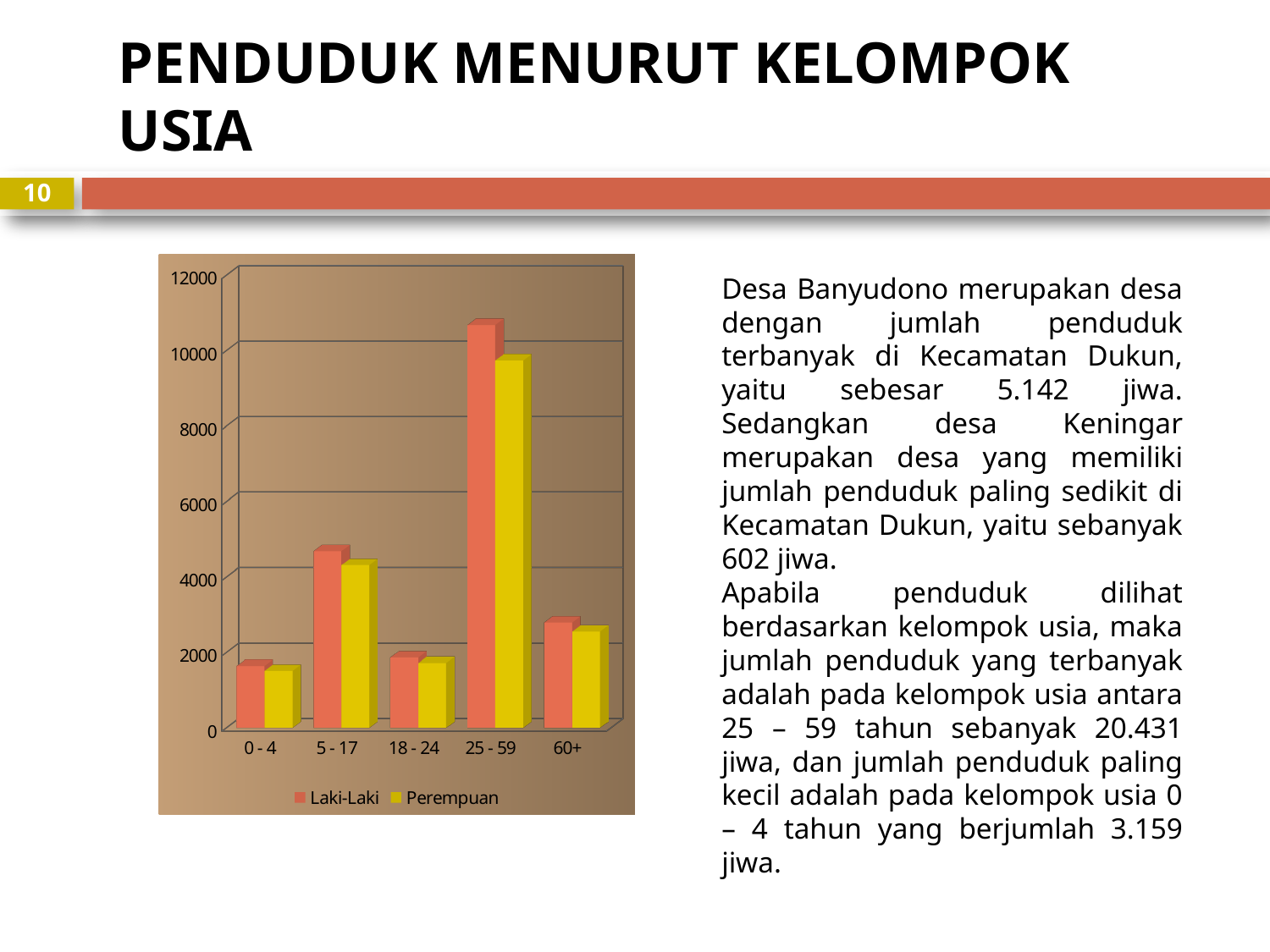
What kind of chart is shown on the slide? bar chart Is the Laki-Laki value for the 5 - 17 age group greater or less than 4000? greater Which age group has the highest Perempuan value in the chart? 25 - 59 For the 5 - 17 age group, which is larger: Laki-Laki or Perempuan? Laki-Laki For the 25 - 59 age group, which is larger: Laki-Laki or Perempuan? Laki-Laki Which age group has the highest Laki-Laki value in the chart? 25 - 59 Is the Laki-Laki value for the 25 - 59 age group greater or less than 10000? greater Which age group has the lowest Laki-Laki value in the chart? 0 - 4 What are the two series names listed in the chart legend? Laki-Laki and Perempuan How many series does the chart legend list? 2 How many age-group categories are shown on the x axis of the chart? 5